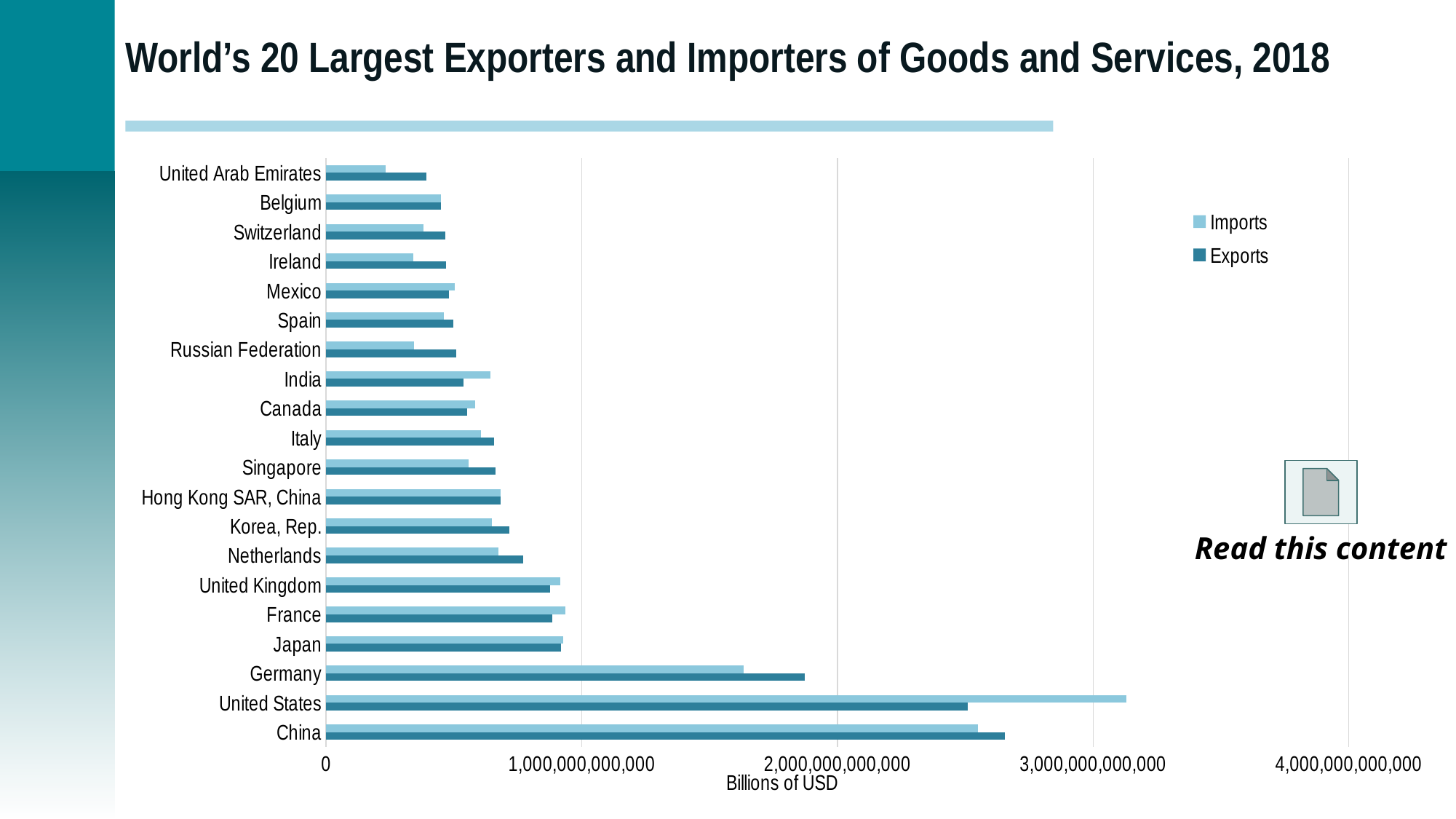
What kind of chart is shown on the slide? bar chart Which is larger, the Imports value for United States or the Imports value for China? United States Which country has the highest Imports value? United States Which is larger, the Exports value for Germany or the Exports value for Japan? Germany How many countries are plotted on the chart? 20 How many series does the legend list? 2 What is the title of the horizontal axis? Billions of USD Which country has the highest Exports value? China Is the Imports value for Japan greater or less than 1,000,000,000,000? less Is the Imports value for United States greater or less than 3,000,000,000,000? greater Is the Exports value for Germany greater or less than 2,000,000,000,000? less Which country has the lowest Imports value? United Arab Emirates